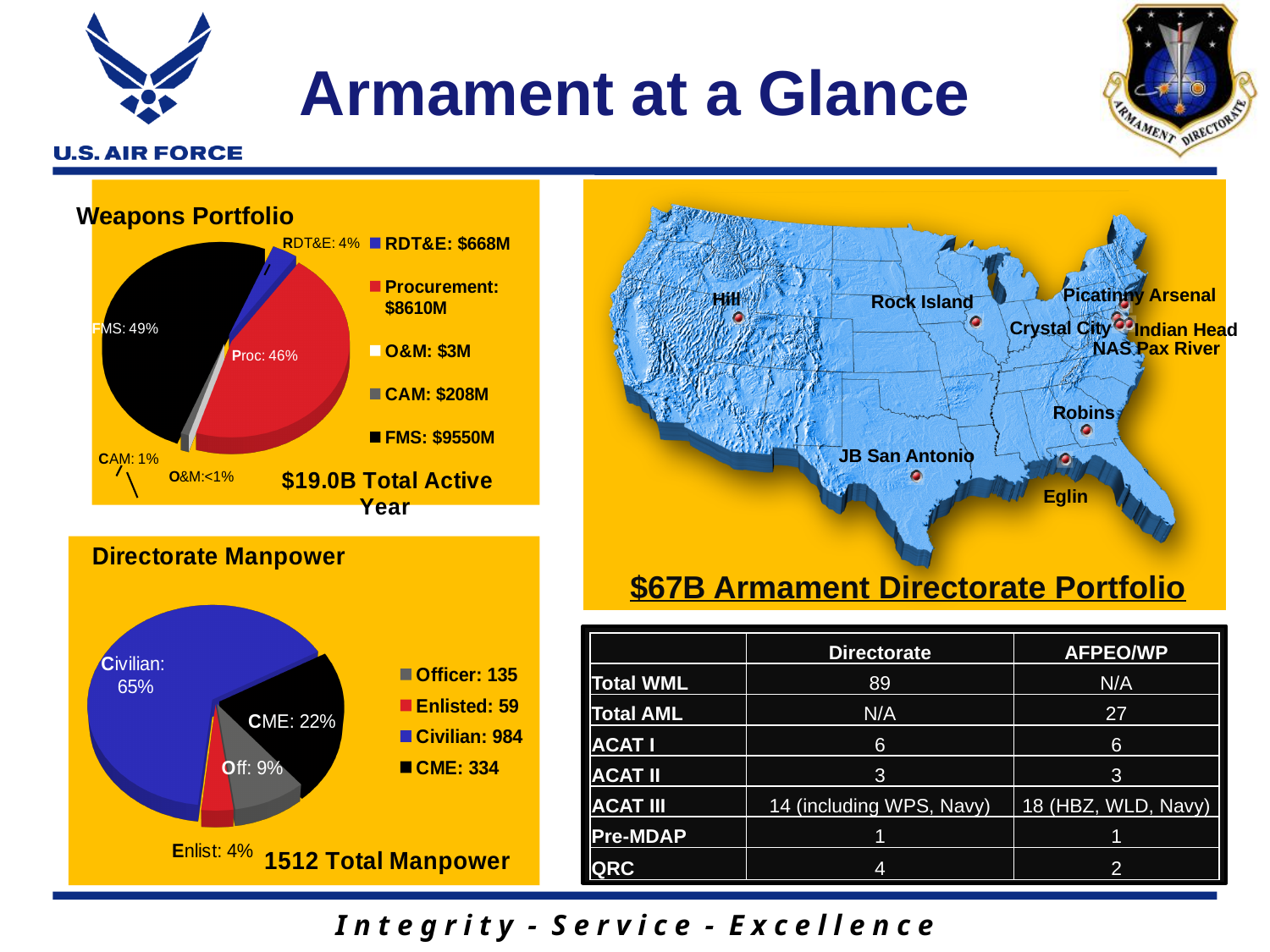
In the Directorate Manpower chart, what is the difference between the CME and Officer values? 199 In the Weapons Portfolio chart, how many categories are shown? 5 In the Weapons Portfolio chart, what is the difference between the FMS and Procurement values? $940M In the Weapons Portfolio chart, what share of the pie is Procurement? 46% In the Directorate Manpower chart, which is larger, Officer or CME? CME In the Weapons Portfolio chart, which category has the largest value? FMS In the Directorate Manpower chart, what is the value for Civilian? 984 What kind of chart is the Weapons Portfolio chart? Pie chart In the Weapons Portfolio chart, which category has the smallest value? O&M In the Directorate Manpower chart, what share of the pie is CME? 22% In the Directorate Manpower chart, which category has the smallest value? Enlisted In the Weapons Portfolio chart, what is the value for FMS? $9550M